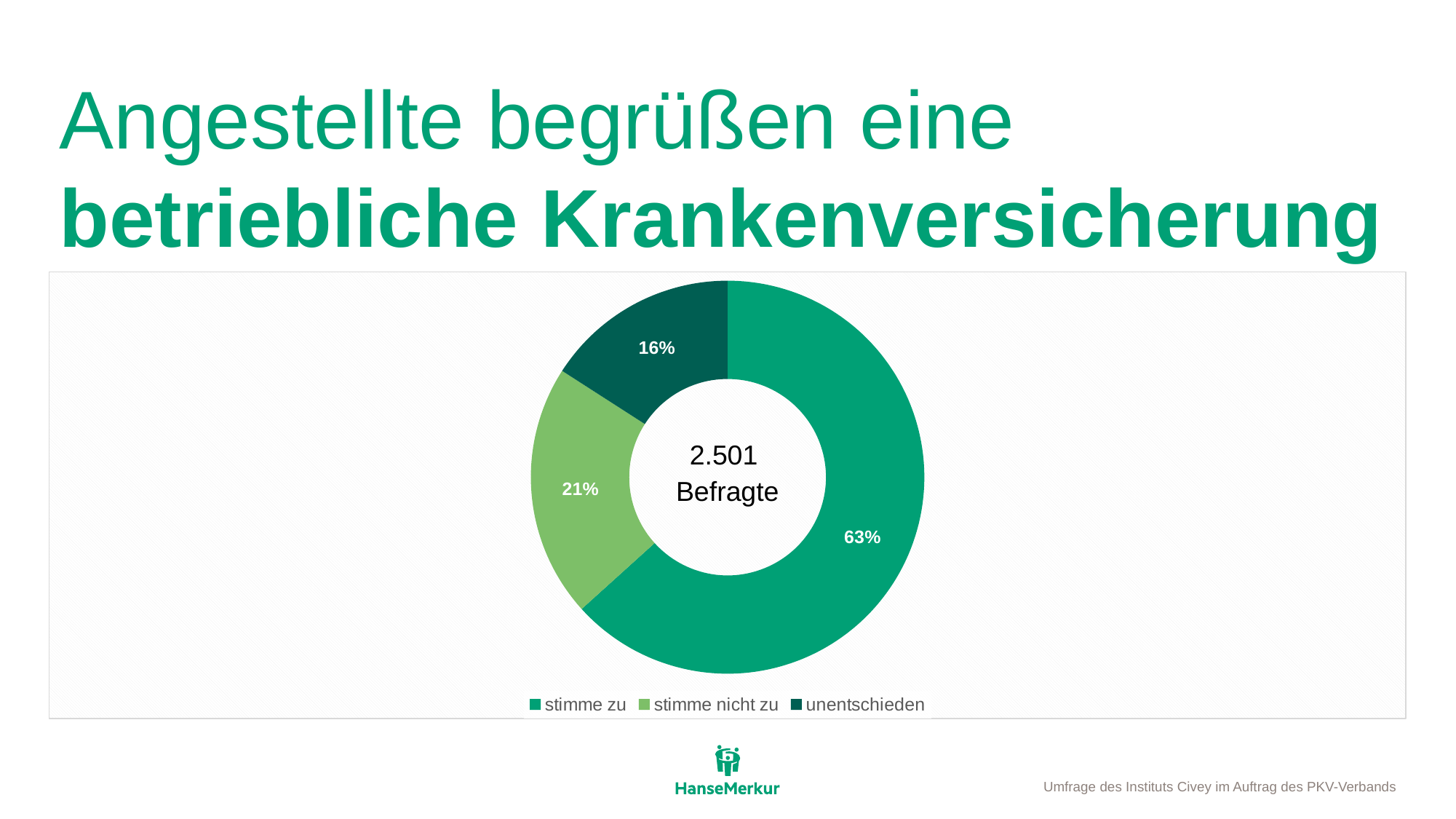
What share of respondents answered "stimme zu"? 63% Which is larger, the share for "stimme nicht zu" or the share for "unentschieden"? stimme nicht zu Which legend entry is shown in the darkest green colour? unentschieden How many respondents does the text in the centre of the chart state? 2.501 Befragte What share of respondents answered "stimme nicht zu"? 21% How many categories does the pie chart show? 3 Which category has the largest share of the pie? stimme zu What is the difference in percentage points between "stimme zu" and "stimme nicht zu"? 42 What share of respondents answered "unentschieden"? 16% What kind of chart is shown on the slide? Pie chart (donut) Which category has the smallest share of the pie? unentschieden What is the difference in percentage points between "stimme nicht zu" and "unentschieden"? 5